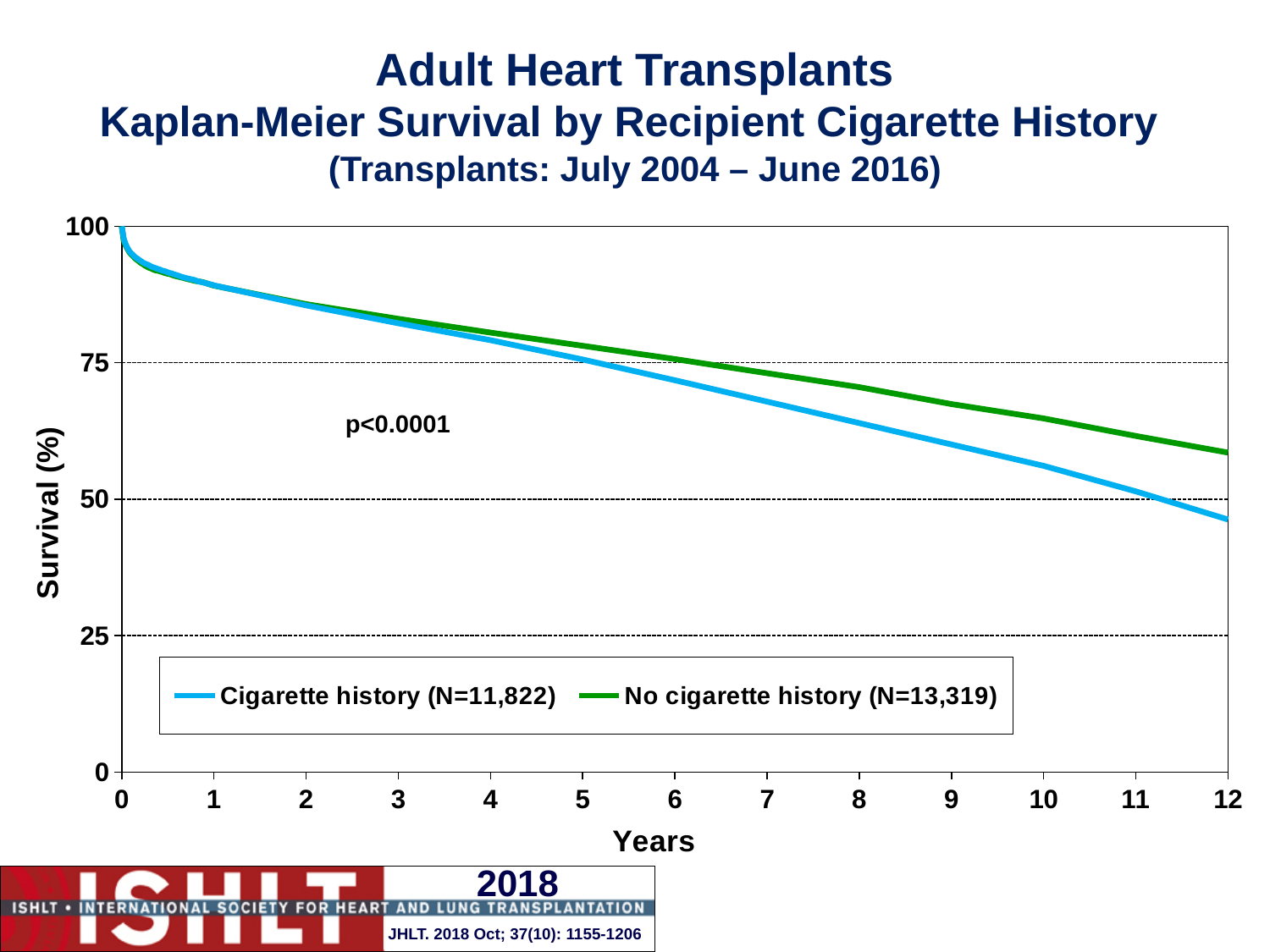
At 2 years, is the survival value for No cigarette history greater or less than 75? greater What kind of chart is shown on the slide? line chart Do the survival curves rise or fall as years increase? fall What p-value is printed on the chart? p<0.0001 What is the highest year shown on the x axis? 12 What is the N for the Cigarette history group shown in the legend? N=11,822 At 10 years, which series has the higher survival: Cigarette history or No cigarette history? No cigarette history How many series does the legend list? 2 At 12 years, is the survival value for Cigarette history greater or less than 50? less At 8 years, is the survival value for Cigarette history greater or less than 75? less